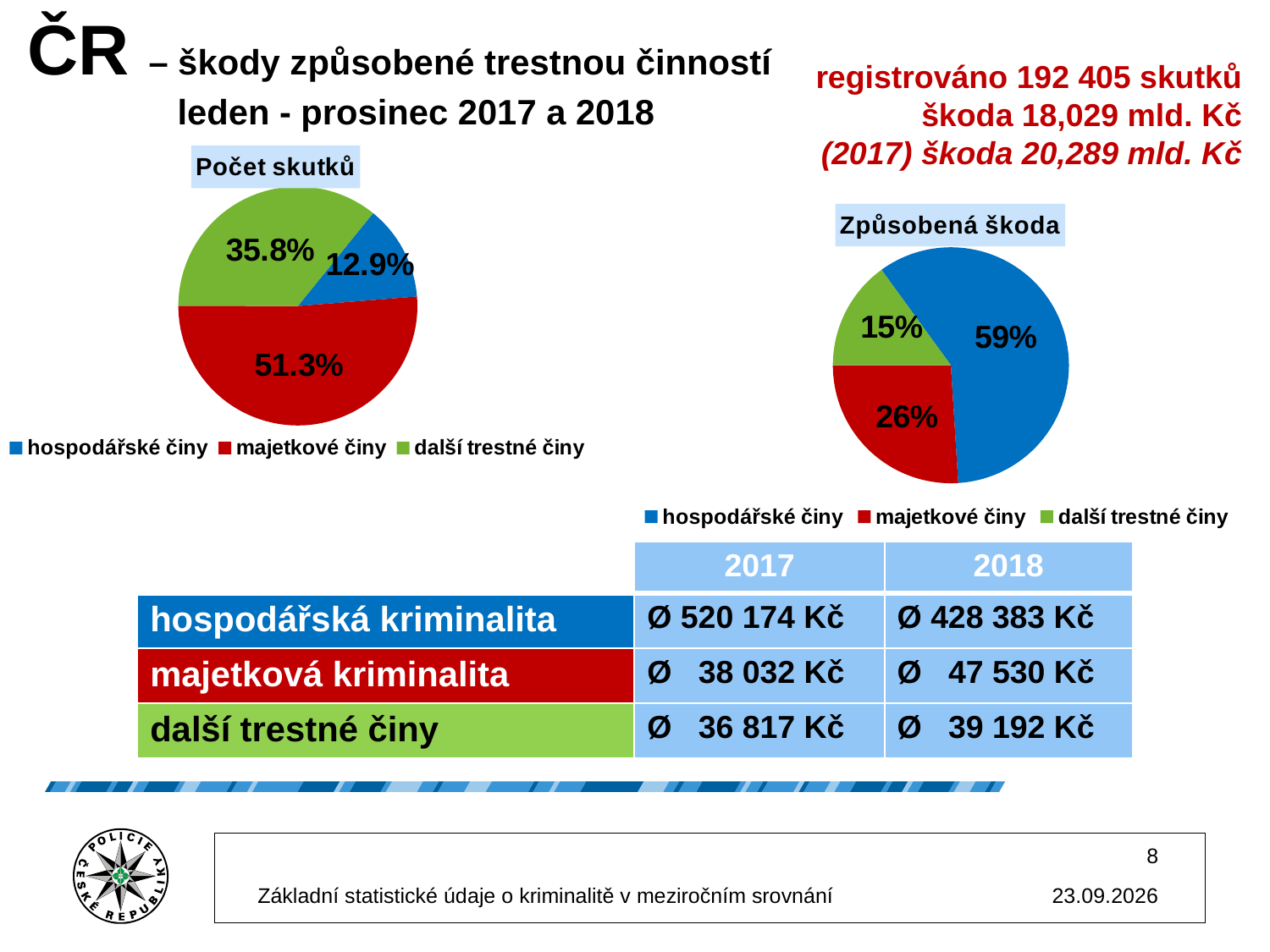
In the 'Způsobená škoda' chart, which category has the smallest slice? další trestné činy In the 'Počet skutků' chart, what is the difference between the shares of majetkové činy and další trestné činy? 15.5% How many categories does the legend of the 'Počet skutků' chart list? 3 In the 'Způsobená škoda' chart, what share do majetkové činy have? 26% In the 'Počet skutků' chart, which category has the largest slice? majetkové činy What type of chart is the 'Způsobená škoda' chart? pie chart In the 'Způsobená škoda' chart, what share do hospodářské činy have? 59% In the 'Počet skutků' chart, what share do další trestné činy have? 35.8% In the 'Způsobená škoda' chart, what share do další trestné činy have? 15% In the 'Počet skutků' chart, what share do majetkové činy have? 51.3% In the 'Způsobená škoda' chart, which is larger: the share of hospodářské činy or majetkové činy? hospodářské činy In the 'Počet skutků' chart, what share do hospodářské činy have? 12.9%